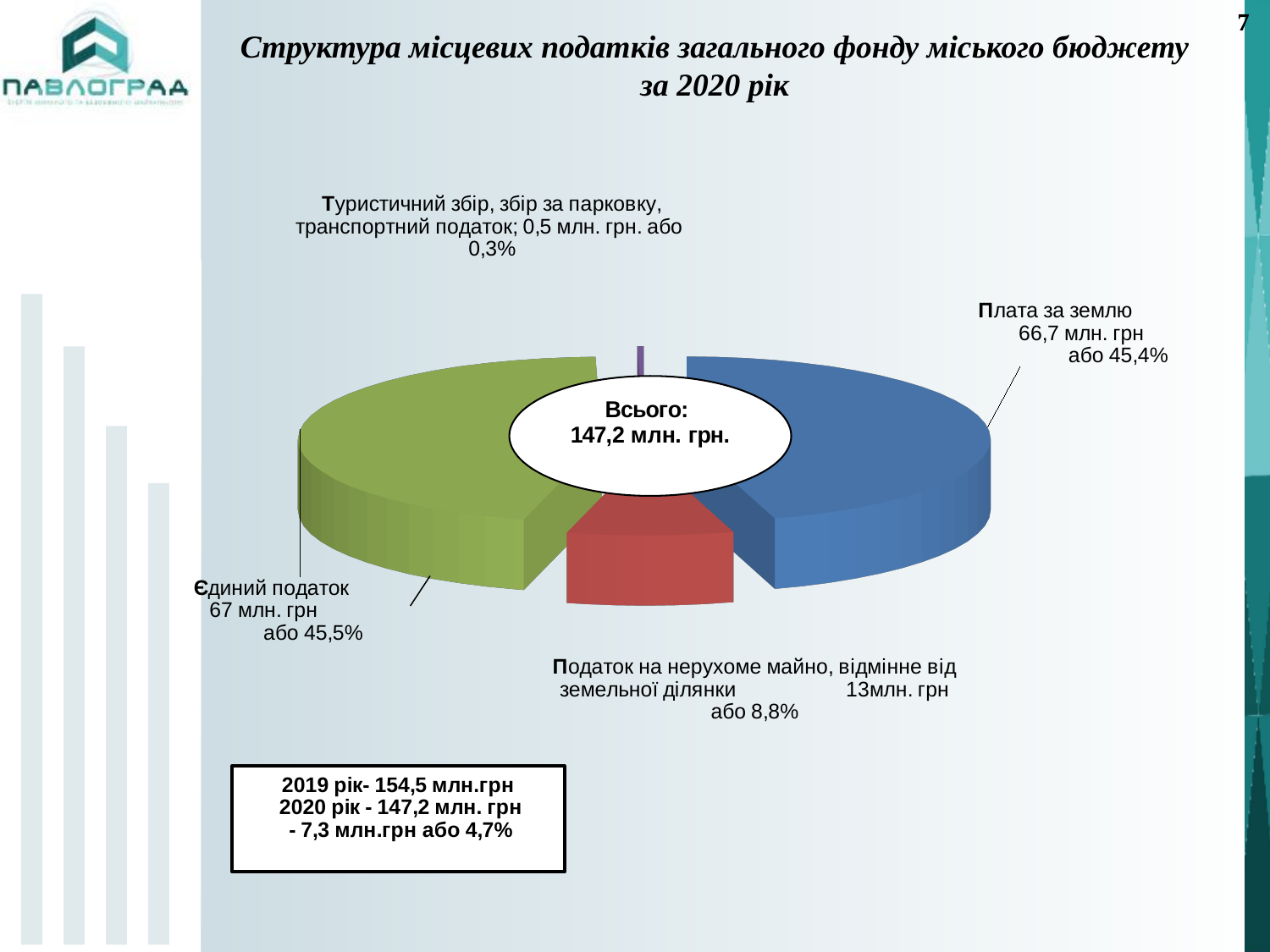
How many slices does the pie chart have? 4 Which is larger: Плата за землю or Податок на нерухоме майно, відмінне від земельної ділянки? Плата за землю What is the title of the chart on the slide? Структура місцевих податків загального фонду міського бюджету за 2020 рік What is the value for Єдиний податок in the pie chart? 67 млн. грн What share of the pie does Туристичний збір, збір за парковку, транспортний податок represent? 0,3% What share of the pie does Плата за землю represent? 45,4% What total is shown in the centre of the pie chart? 147,2 млн. грн. Which category has the smallest slice in the pie chart? Туристичний збір, збір за парковку, транспортний податок What is the difference between Єдиний податок and Податок на нерухоме майно, відмінне від земельної ділянки in млн. грн? 54 млн. грн What kind of chart is shown on the slide? pie chart What is the value for Податок на нерухоме майно, відмінне від земельної ділянки? 13 млн. грн What is the value for Плата за землю in the pie chart? 66,7 млн. грн